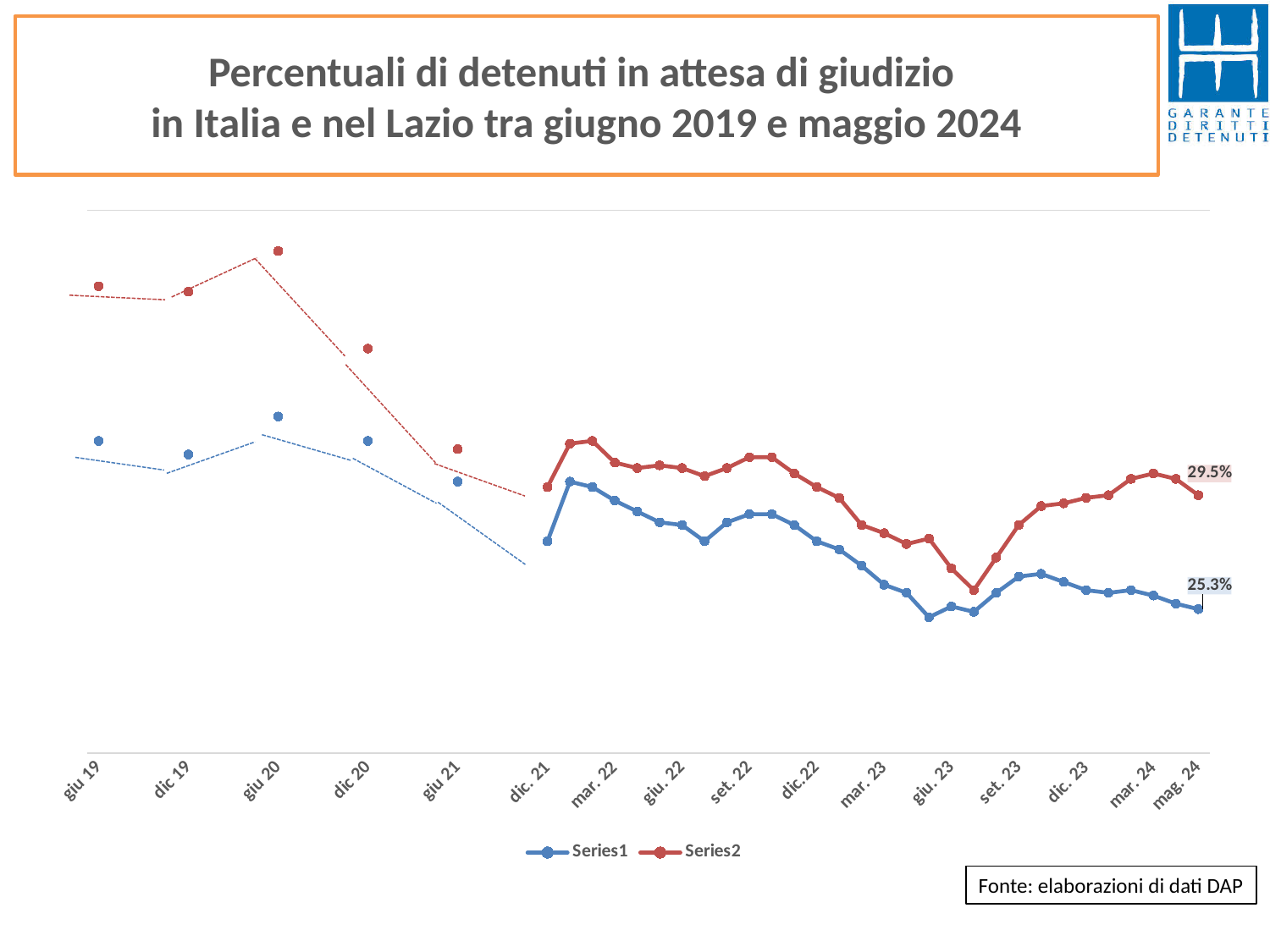
How many labels are shown on the x axis? 16 At mag. 24, which series has the higher value, Series1 or Series2? Series2 Overall, do the values of Series2 rise or fall from giu 19 to mag. 24? fall At which x-axis label does Series2 reach its highest value? giu 20 How many series does the legend list? 2 What type of chart is shown on the slide? line chart What is the title of the chart? Percentuali di detenuti in attesa di giudizio in Italia e nel Lazio tra giugno 2019 e maggio 2024 What colour is the line for Series2? red What is the value of Series2 at mag. 24? 29.5% What is the value of Series1 at mag. 24? 25.3% What is the difference between the Series2 and Series1 values at mag. 24? 4.2 percentage points